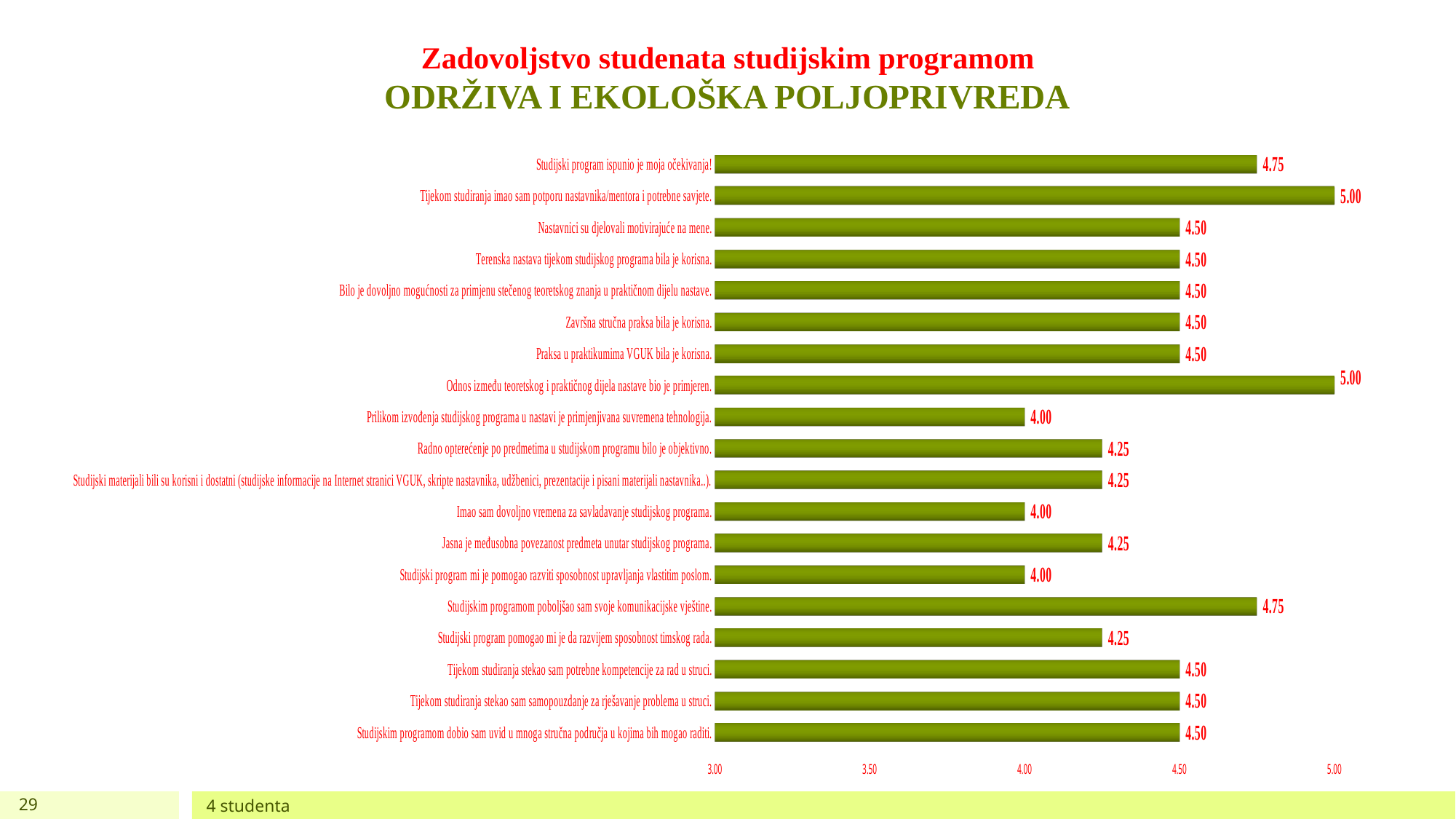
What is the value for "Odnos između teoretskog i praktičnog dijela nastave bio je primjeren."? 5.00 What is the title of the chart on the slide? Zadovoljstvo studenata studijskim programom ODRŽIVA I EKOLOŠKA POLJOPRIVREDA What is the value for "Prilikom izvođenja studijskog programa u nastavi je primjenjivana suvremena tehnologija."? 4.00 Which has a larger value: "Studijskim programom poboljšao sam svoje komunikacijske vještine." or "Studijski program pomogao mi je da razvijem sposobnost timskog rada."? Studijskim programom poboljšao sam svoje komunikacijske vještine. What is the highest value shown on the chart? 5.00 What kind of chart is shown on the slide? bar chart What is the value for "Studijski program ispunio je moja očekivanja!"? 4.75 What is the value for "Radno opterećenje po predmetima u studijskom programu bilo je objektivno."? 4.25 What is the lowest value shown on the chart? 4.00 What is the difference between the values for "Tijekom studiranja imao sam potporu nastavnika/mentora i potrebne savjete." and "Imao sam dovoljno vremena za savladavanje studijskog programa."? 1.00 Is the value for "Jasna je međusobna povezanost predmeta unutar studijskog programa." greater or less than 4.50? less How many statements (bars) are shown on the chart? 19